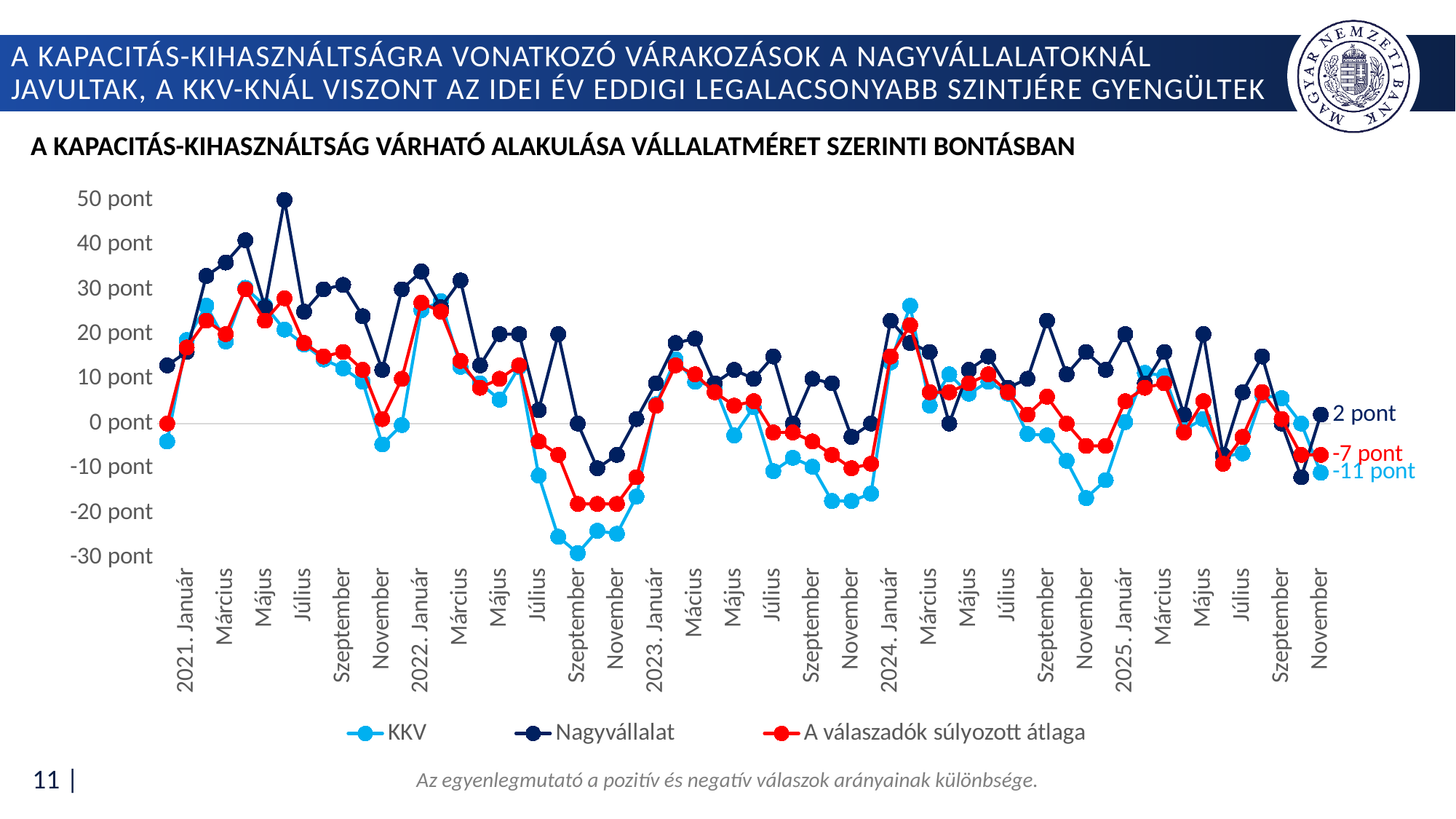
At the last data point, what is the difference between the Nagyvállalat value and the KKV value? 13 pont What is the value of the Nagyvállalat series at the last data point (2025 November)? 2 pont Is the highest value reached by the Nagyvállalat series greater or less than 40 pont? greater Which series reaches the highest value anywhere on the chart? Nagyvállalat How many series does the legend list? 3 At the last data point, which series has the higher value: KKV or Nagyvállalat? Nagyvállalat What colour is the KKV series drawn in? light blue Which series reaches the lowest value anywhere on the chart? KKV What is the value of the KKV series at the last data point (2025 November)? -11 pont What is the value of 'A válaszadók súlyozott átlaga' at the last data point (2025 November)? -7 pont Is the lowest value reached by the KKV series greater or less than -20 pont? less What kind of chart is shown on the slide? line chart